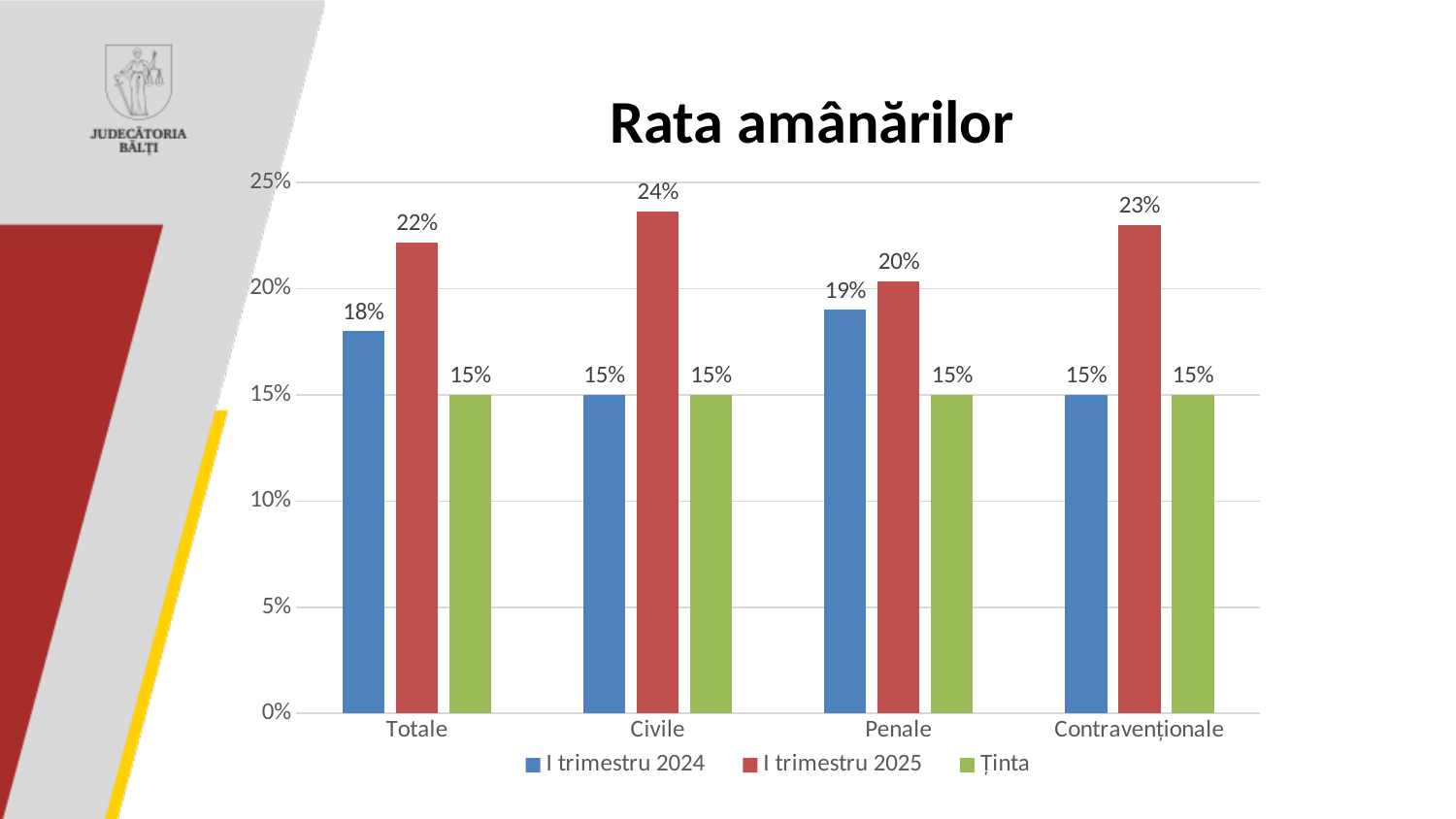
Which category has the highest value in the I trimestru 2024 series? Penale Which is larger for Penale: the I trimestru 2024 value or the I trimestru 2025 value? I trimestru 2025 How many categories are shown on the x axis? 4 What is the difference between the I trimestru 2025 and I trimestru 2024 values for Totale? 4% What is the title of the chart? Rata amânărilor What kind of chart is shown on the slide? Bar chart What is the difference between the I trimestru 2025 and I trimestru 2024 values for Contravenționale? 8% What is the value for Totale in the I trimestru 2025 series? 22% What is the value for Civile in the I trimestru 2025 series? 24% How many series does the legend list? 3 What is the value for Penale in the I trimestru 2024 series? 19% Which category has the highest value in the I trimestru 2025 series? Civile